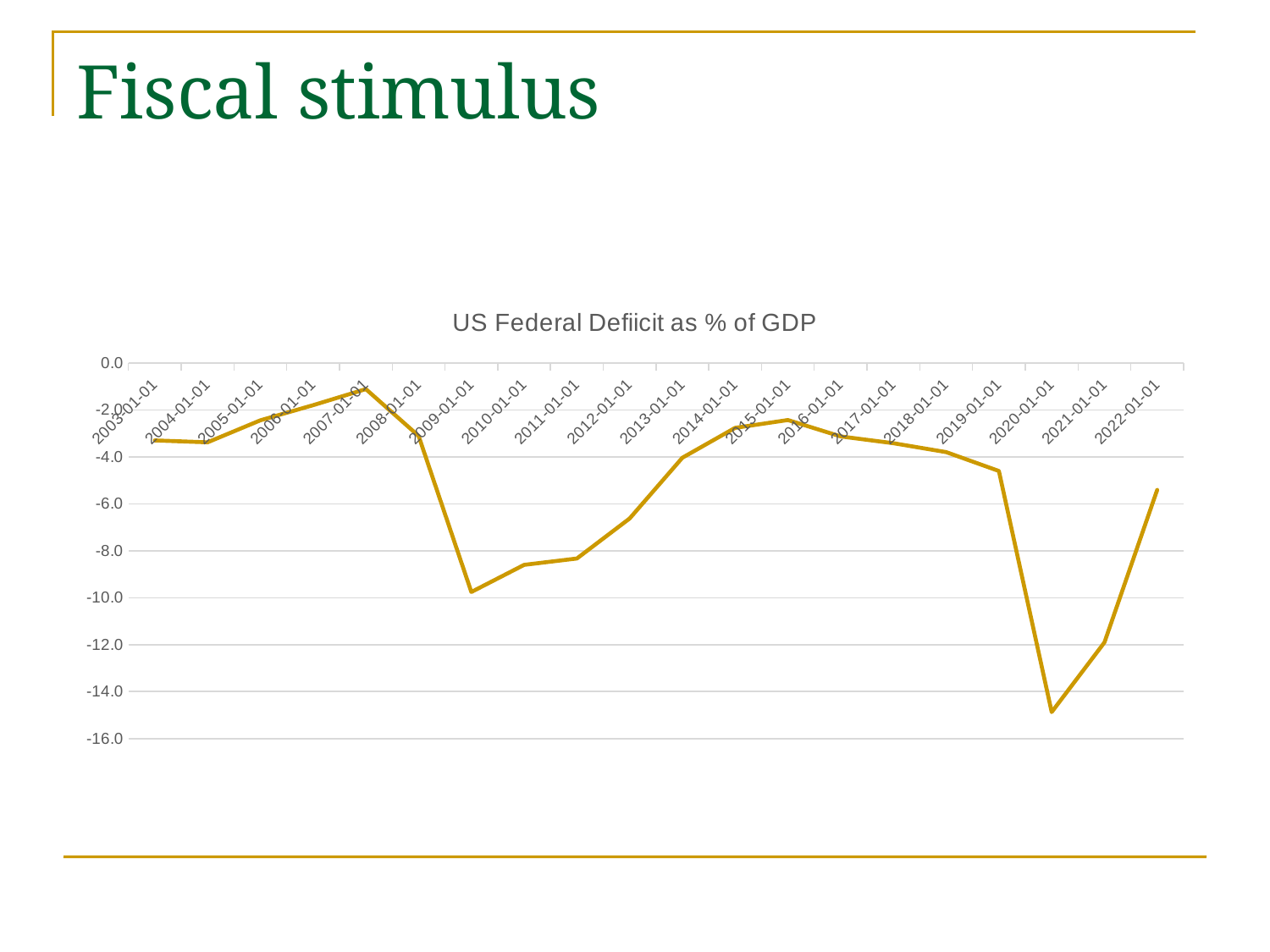
Which is lower, the value for 2009-01-01 or the value for 2020-01-01? 2020-01-01 Is the value for 2007-01-01 greater or less than -2.0? greater Which date has the highest value on the chart? 2007-01-01 Is the value for 2009-01-01 greater or less than -8.0? less Do the values rise or fall from 2009-01-01 to 2015-01-01? rise How many data points are plotted on the chart? 20 What kind of chart is shown on the slide? line chart Is the value for 2020-01-01 greater or less than -14.0? less Which date has the lowest value on the chart? 2020-01-01 Do the values rise or fall from 2015-01-01 to 2020-01-01? fall What is the title of the chart? US Federal Defiicit as % of GDP